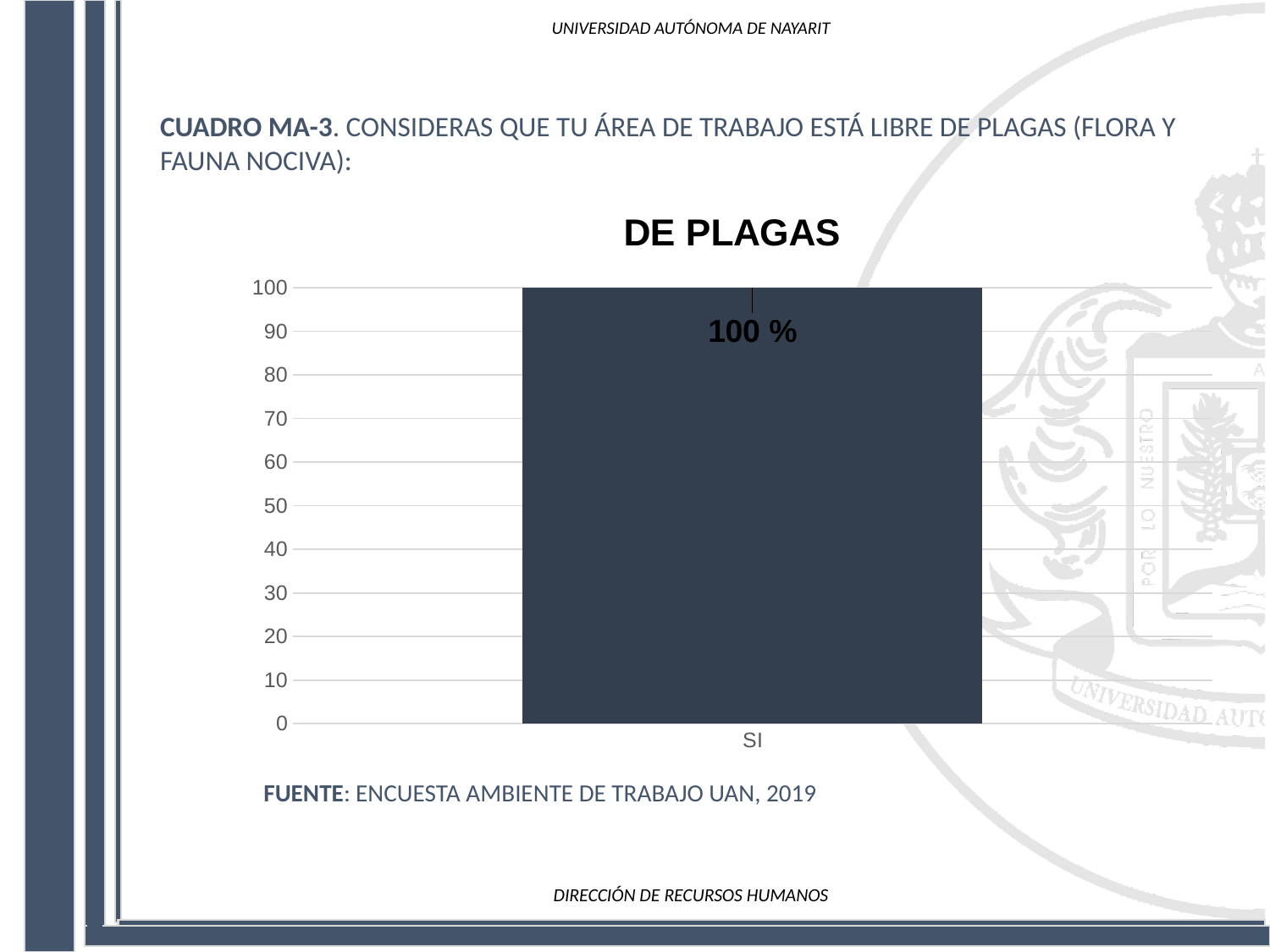
What is the highest value shown on the y axis? 100 How many categories are plotted on the x axis of the chart? 1 Is the value for SI greater or less than 50? greater What is the value shown for the SI category? 100 % Which category has the highest value in the chart? SI What kind of chart is shown on the slide? bar chart What is the title of the chart? DE PLAGAS What is the label of the only category on the x axis? SI